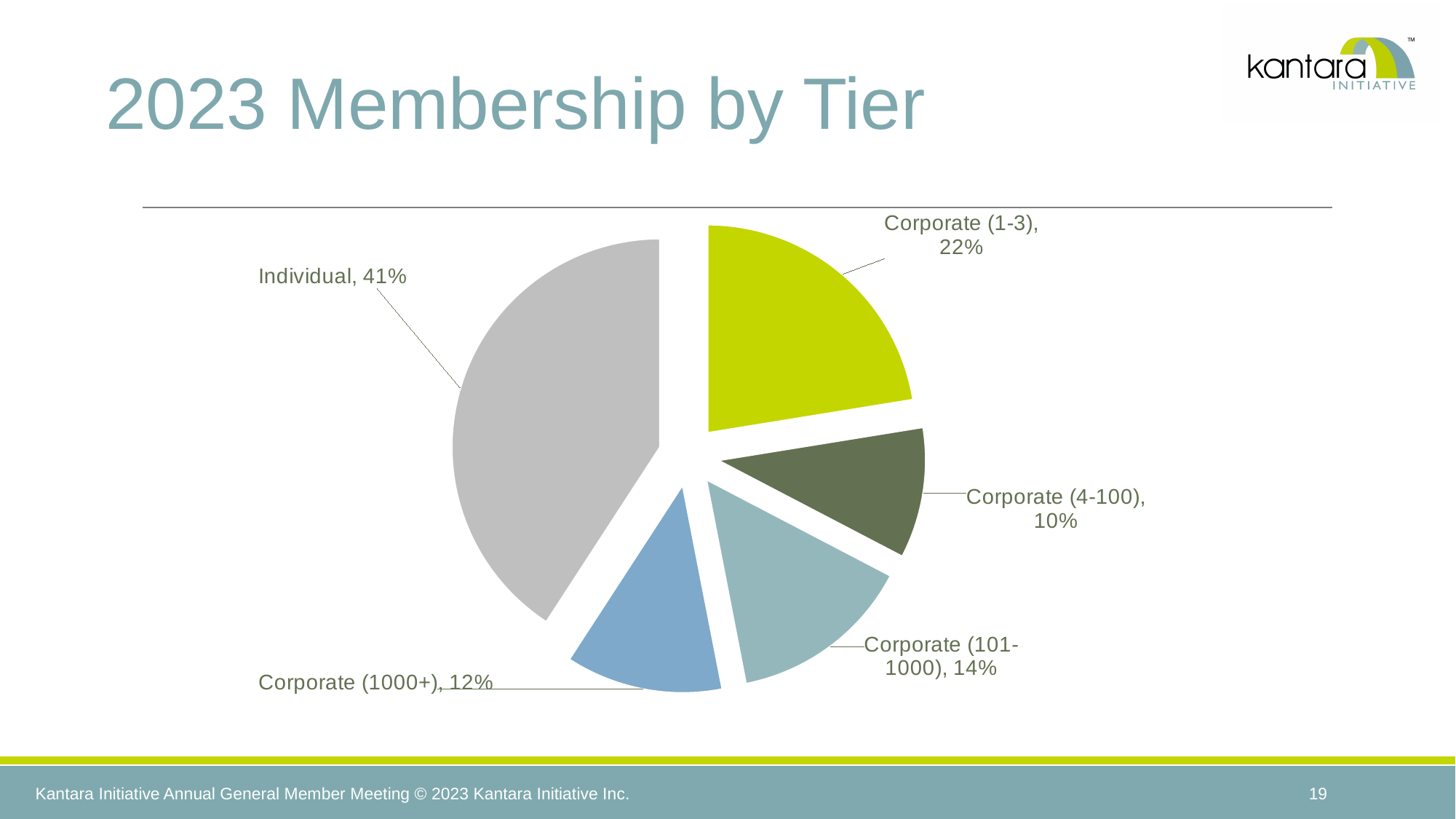
What percentage of membership is in the Corporate (1-3) tier? 22% Which membership tier has the largest share? Individual What is the difference in percentage points between the Individual and Corporate (1-3) shares? 19 What share of 2023 membership is Individual? 41% What type of chart is shown on the slide? Pie chart What is the title of the slide containing the chart? 2023 Membership by Tier How many membership tiers are shown in the pie chart? 5 Which has a larger share, Corporate (101-1000) or Corporate (1000+)? Corporate (101-1000) What percentage of membership is in the Corporate (1000+) tier? 12% What percentage of membership is in the Corporate (4-100) tier? 10% Which membership tier has the smallest share? Corporate (4-100) What percentage of membership is in the Corporate (101-1000) tier? 14%